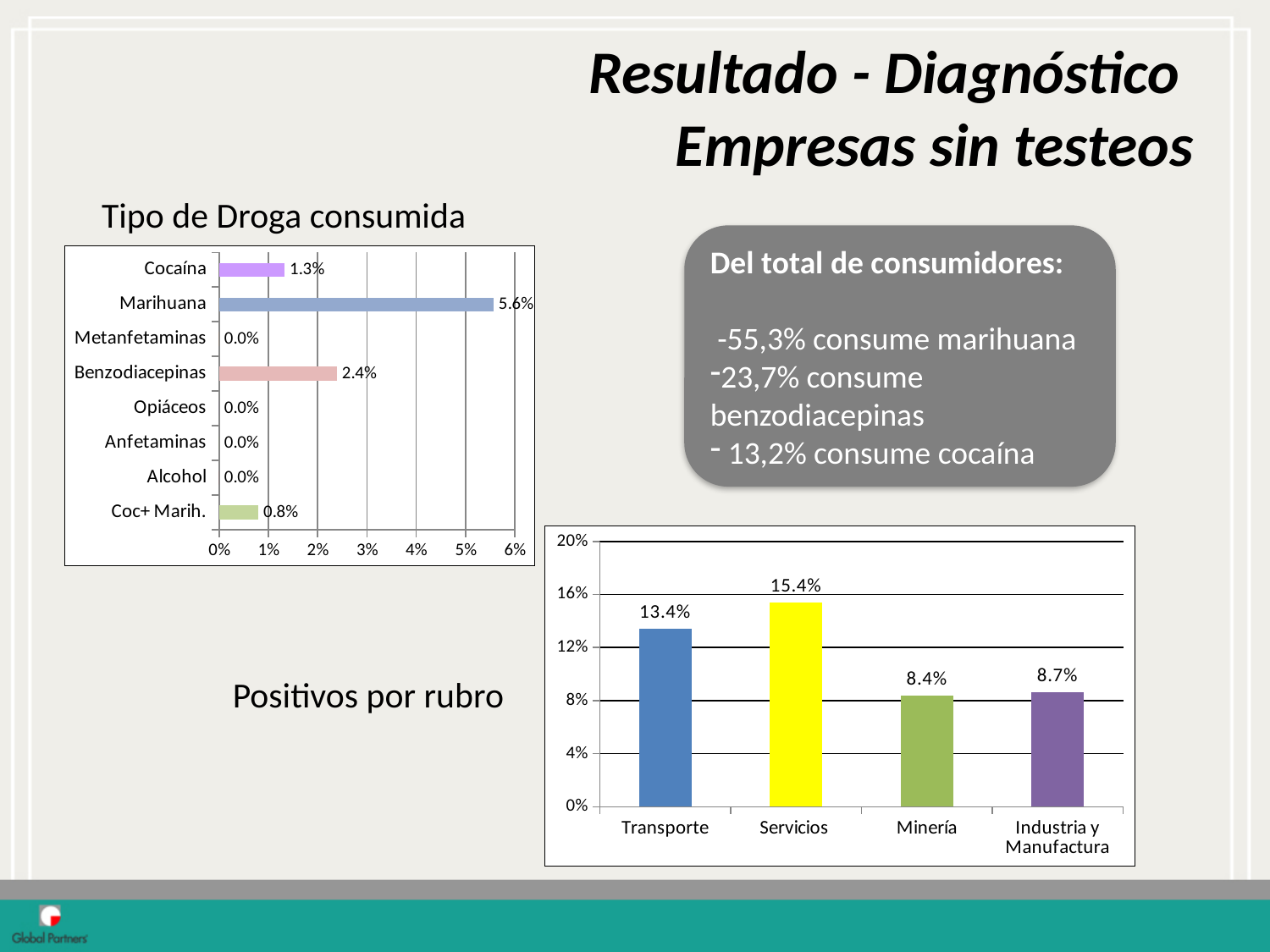
In the 'Positivos por rubro' chart, what is the value for Servicios? 15.4% In the 'Tipo de Droga consumida' chart, which category has the highest value? Marihuana In the 'Tipo de Droga consumida' chart, how many categories have a value of 0.0%? 4 In the 'Positivos por rubro' chart, which category has the lowest value? Minería In the 'Positivos por rubro' chart, which is larger, Transporte or Industria y Manufactura? Transporte In the 'Tipo de Droga consumida' chart, what is the value for Marihuana? 5.6% In the 'Tipo de Droga consumida' chart, what is the value for Benzodiacepinas? 2.4% In the 'Tipo de Droga consumida' chart, how many categories are shown? 8 In the 'Tipo de Droga consumida' chart, what is the difference between Marihuana and Cocaína? 4.3% In the 'Positivos por rubro' chart, what is the difference between Servicios and Transporte? 2.0% What type of chart is the 'Positivos por rubro' chart? Bar chart In the 'Positivos por rubro' chart, what is the value for Minería? 8.4%